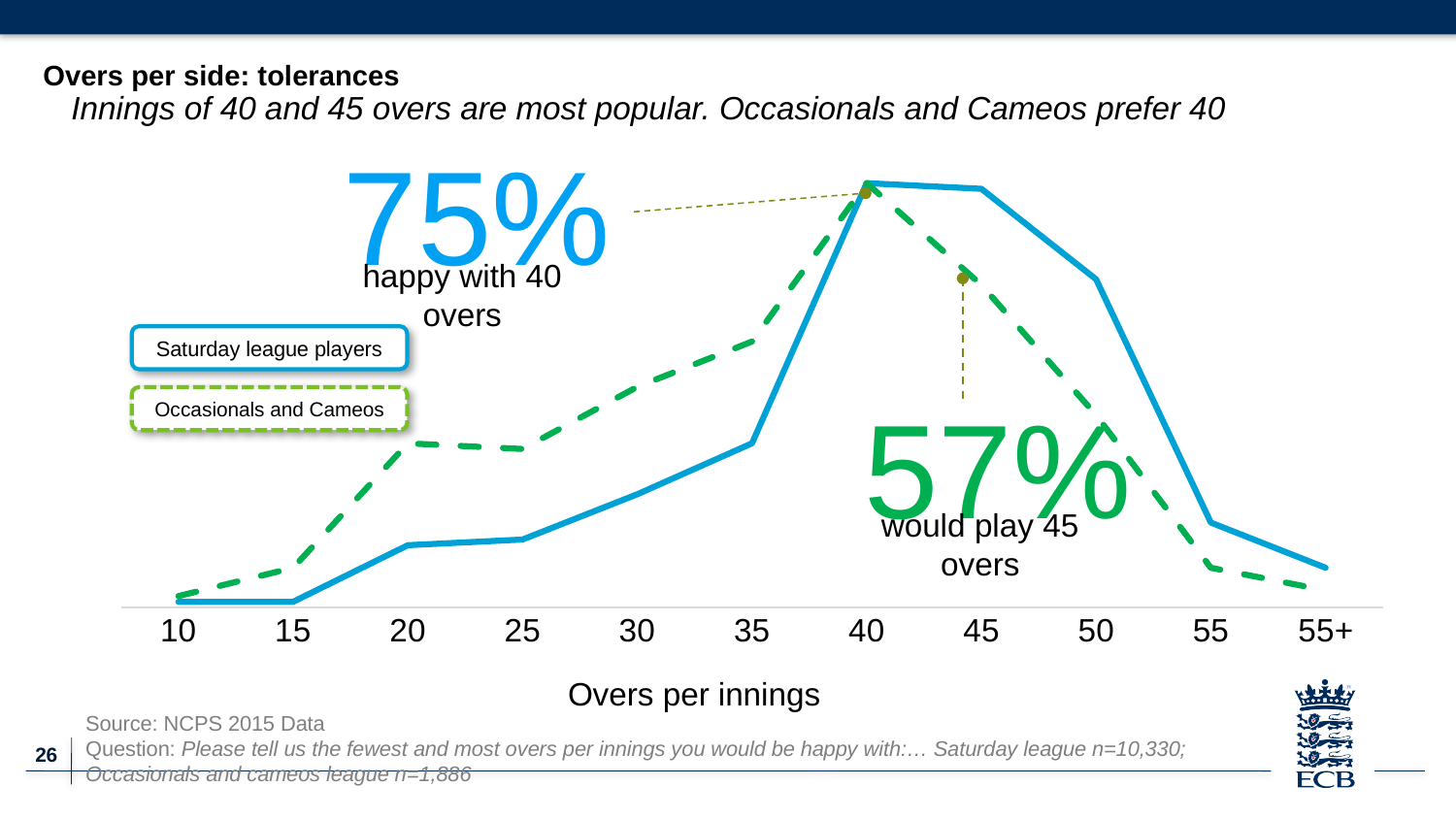
Which series is drawn as a dashed green line? Occasionals and Cameos Does the Occasionals and Cameos line rise or fall between 45 and 55+ overs per innings? fall What is the title of the chart's x axis? Overs per innings How many categories are shown along the x axis of the chart? 11 At 50 overs per innings, which series has the higher value: Saturday league players or Occasionals and Cameos? Saturday league players What percentage is shown in the callout for being happy with 40 overs? 75% At which overs-per-innings value does the Occasionals and Cameos line reach its highest point? 40 How many series does the chart's legend list? 2 What percentage of Occasionals and Cameos would play 45 overs, according to the callout on the chart? 57% Does the Saturday league players line rise or fall between 10 and 40 overs per innings? rise At 20 overs per innings, which series has the higher value: Saturday league players or Occasionals and Cameos? Occasionals and Cameos What kind of chart is shown on the slide? line chart